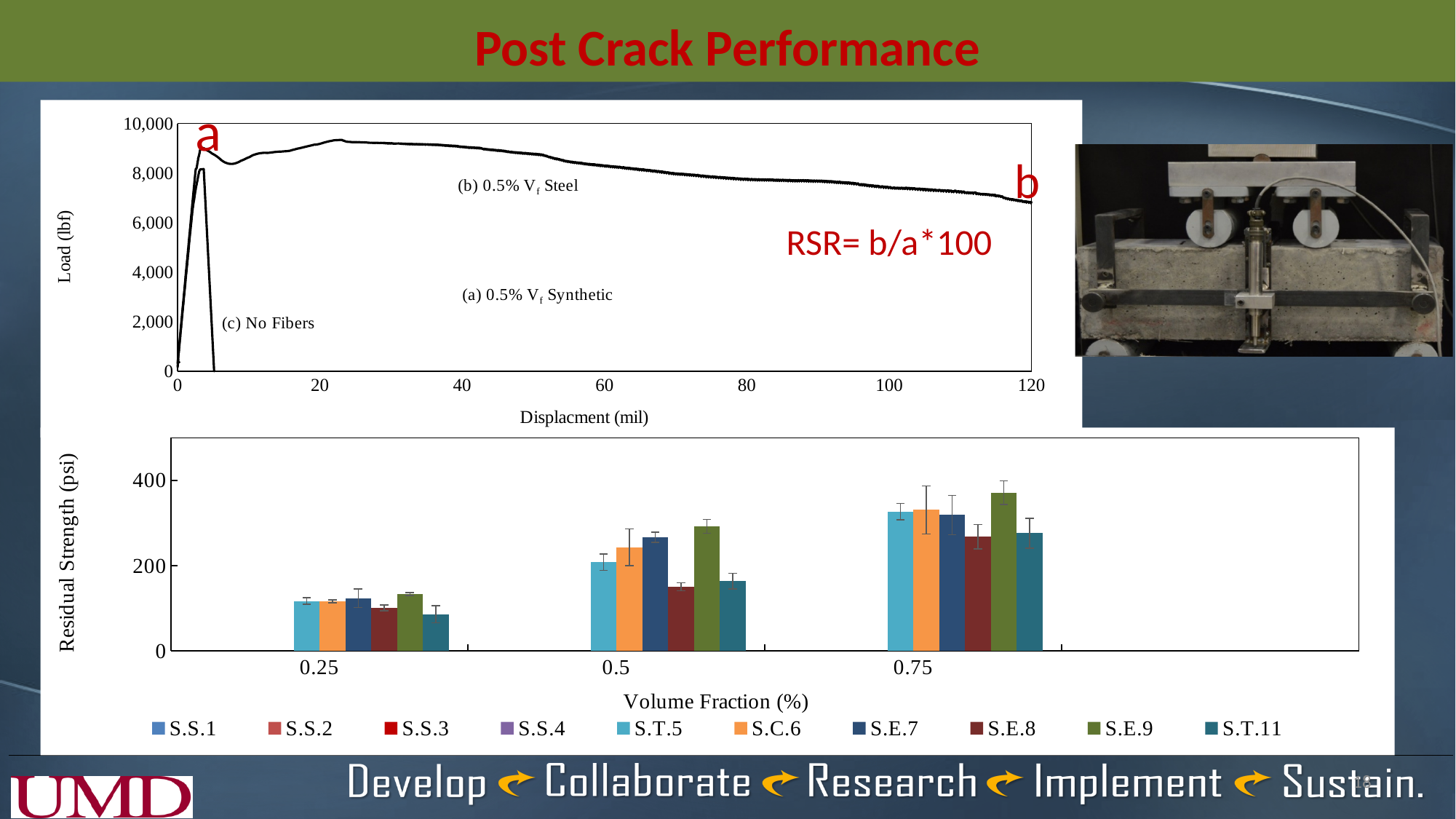
In the bottom bar chart, how many series does the legend list? 10 In the bottom bar chart, which is larger at volume fraction 0.75: S.E.9 or S.E.8? S.E.9 In the bottom bar chart, is the value for S.T.11 at volume fraction 0.25 greater or less than 200? less What kind of chart is the bottom chart (Residual Strength vs Volume Fraction)? bar chart In the bottom bar chart, does the residual strength for S.E.9 rise or fall as volume fraction increases from 0.25 to 0.75? rise In the bottom bar chart, how many volume fraction categories are shown on the x axis? 3 What kind of chart is the top chart (Load vs Displacement)? line chart In the top line chart, is the load for the 0.5% Vf Steel curve at displacement 120 greater or less than 8,000? less In the bottom bar chart, which series has the highest residual strength at volume fraction 0.75? S.E.9 What is the x-axis label of the bottom bar chart? Volume Fraction (%) In the bottom bar chart, is the value for S.E.9 at volume fraction 0.75 greater or less than 200? greater